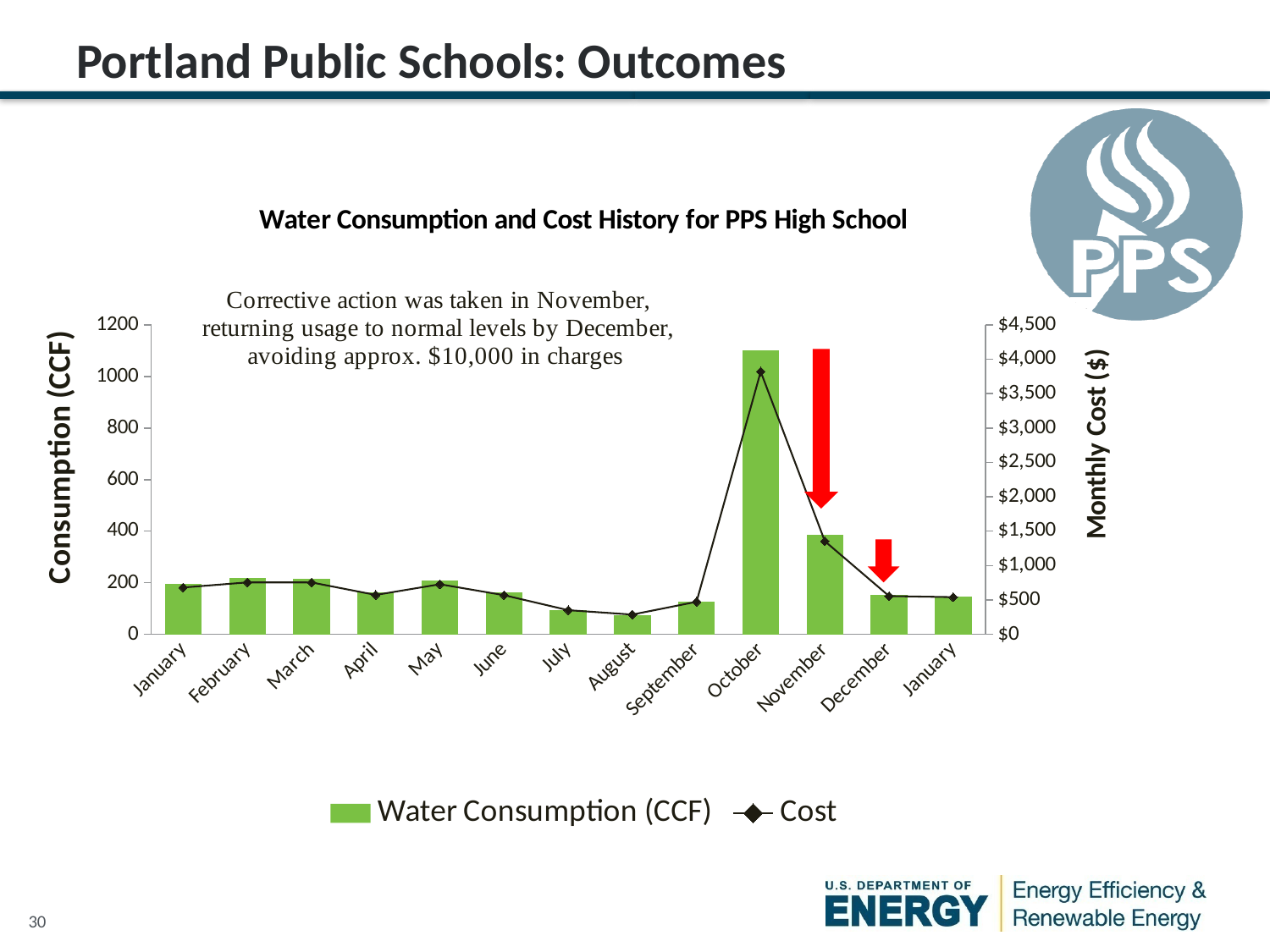
How many months are shown along the x axis? 13 What kind of chart is used to show Water Consumption (CCF)? bar chart Is the water consumption for October greater or less than 1000 CCF? greater Which month has the larger water consumption, October or November? October Does water consumption rise or fall from October to December? fall What is the title of the chart? Water Consumption and Cost History for PPS High School Which month has the highest water consumption? October Is the cost for October greater or less than $3,500? greater What kind of chart is used to show Cost? line chart Which month has the lowest water consumption? August Is the water consumption for August greater or less than 200 CCF? less How many series does the legend list? 2